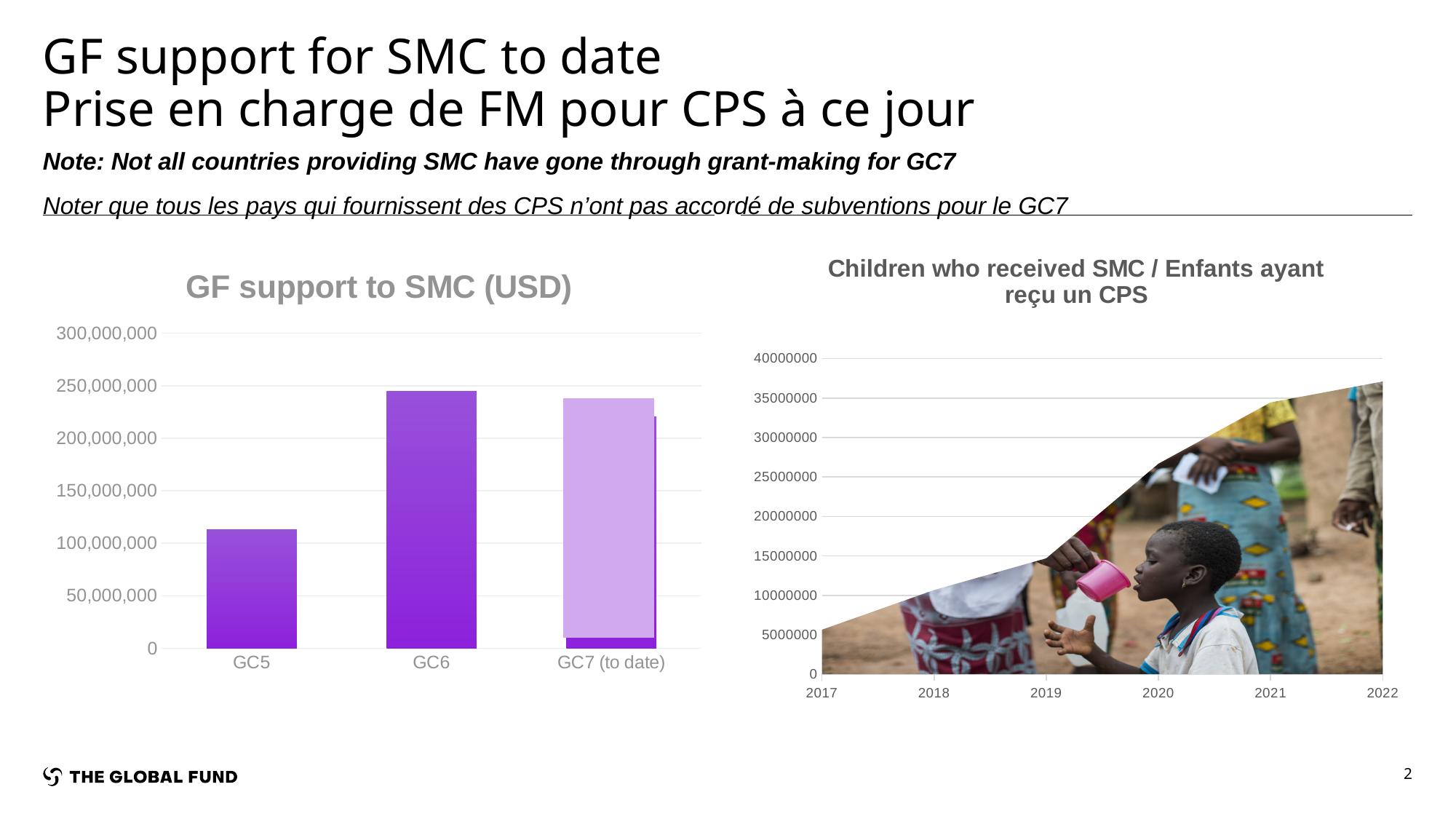
On the chart titled "Children who received SMC / Enfants ayant reçu un CPS", do the values rise or fall from 2017 to 2022? rise On the chart titled "Children who received SMC / Enfants ayant reçu un CPS", how many years are shown on the x axis? 6 On the chart titled "Children who received SMC / Enfants ayant reçu un CPS", is the value for 2020 greater or less than 20000000? greater On the chart titled "GF support to SMC (USD)", is the value for GC5 greater or less than 100,000,000? greater On the chart titled "Children who received SMC / Enfants ayant reçu un CPS", is the value for 2017 greater or less than 10000000? less On the chart titled "GF support to SMC (USD)", which is larger, the value for GC5 or the value for GC6? GC6 On the chart titled "GF support to SMC (USD)", which category has the lowest value? GC5 What kind of chart is the chart titled "GF support to SMC (USD)"? bar chart On the chart titled "GF support to SMC (USD)", how many categories are shown on the x axis? 3 On the chart titled "Children who received SMC / Enfants ayant reçu un CPS", which year has the highest value? 2022